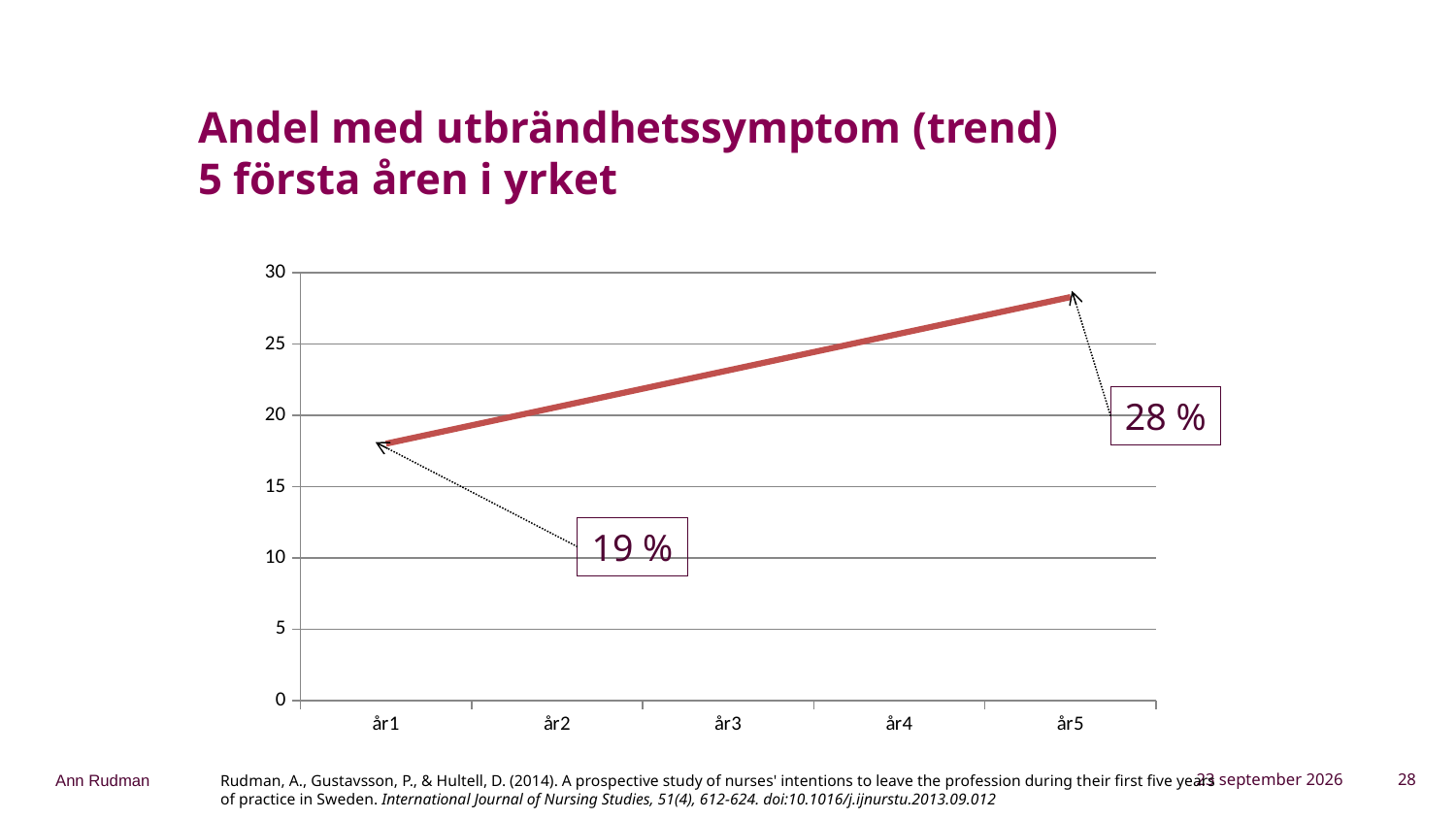
What is the value shown for år5? 28 % Does the line rise or fall from år1 to år5? rises Which is larger, the value for år1 or the value for år5? år5 Is the value for år5 greater or less than 25? greater What kind of chart is shown on the slide? line chart How many years are shown on the x axis? 5 Is the value for år1 greater or less than 20? less Which year has the highest value on the chart? år5 What is the title of the slide? Andel med utbrändhetssymptom (trend) 5 första åren i yrket What is the difference between the value for år5 and the value for år1? 9 % Which year has the lowest value on the chart? år1 What is the value shown for år1? 19 %